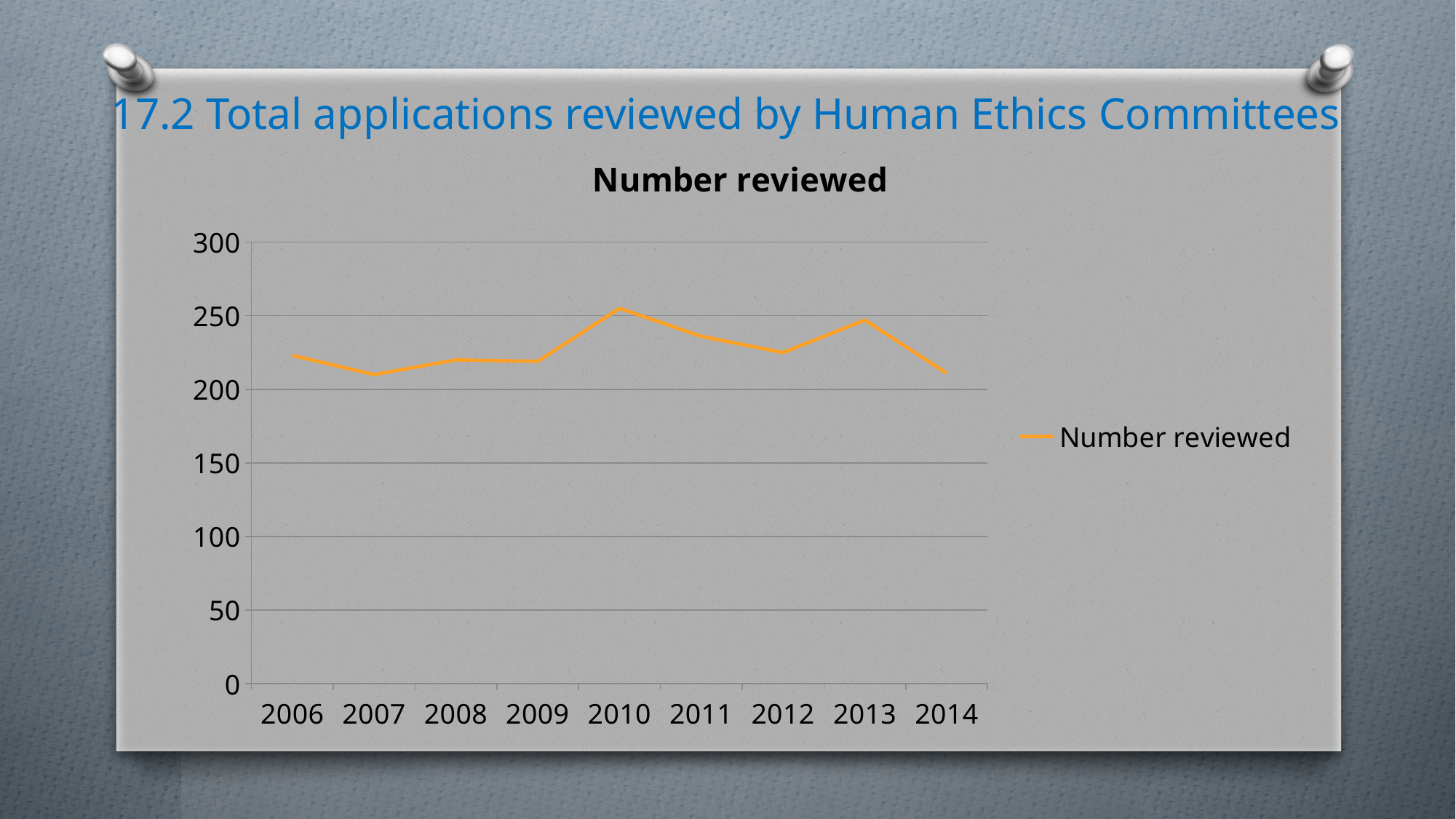
Which is larger, the value for 2010 or the value for 2007? 2010 What kind of chart is shown on the slide? line chart Does the number reviewed rise or fall from 2013 to 2014? fall Which year has the highest number reviewed? 2010 How many series does the legend list? 1 Is the value for 2007 greater or less than 200? greater Which is larger, the value for 2013 or the value for 2012? 2013 Is the value for 2011 greater or less than 250? less How many years are plotted along the x axis? 9 What is the title of the chart? Number reviewed Does the number reviewed rise or fall from 2009 to 2010? rise